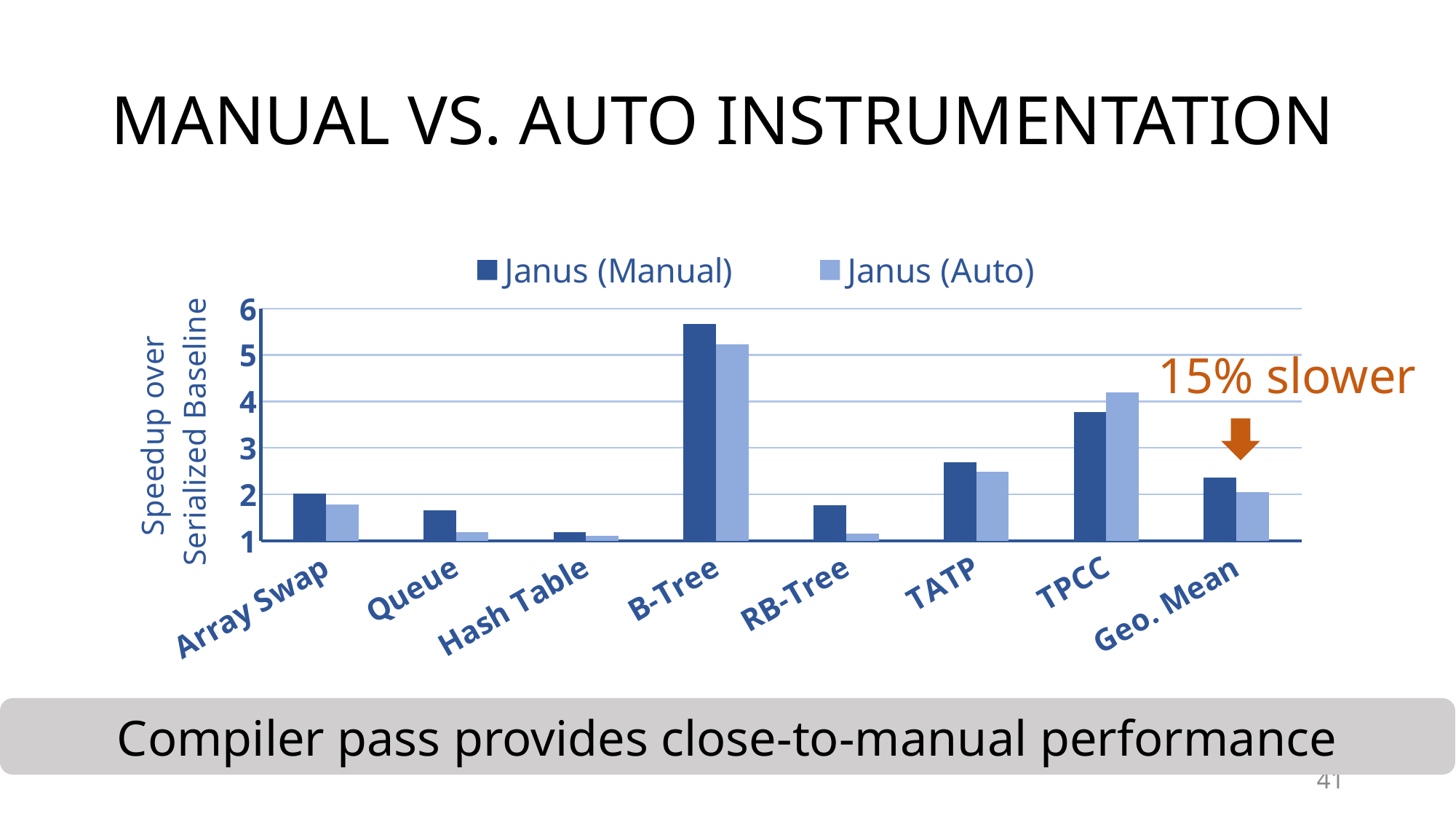
Which category has the highest Janus (Manual) speedup? B-Tree Which category has the lowest Janus (Auto) speedup? Hash Table What kind of chart is shown on the slide? bar chart How many series does the legend list? 2 What is the label of the y axis? Speedup over Serialized Baseline According to the annotation, how much slower is the Geo. Mean for Janus (Auto) compared to Janus (Manual)? 15% slower Is the Janus (Auto) value for Queue greater or less than 2? less Is the Janus (Manual) value for B-Tree greater or less than 5? greater For RB-Tree, which is larger: Janus (Manual) or Janus (Auto)? Janus (Manual) How many categories are shown on the x axis? 8 Is the Janus (Auto) value for TPCC greater or less than 4? greater For TPCC, which is larger: Janus (Manual) or Janus (Auto)? Janus (Auto)